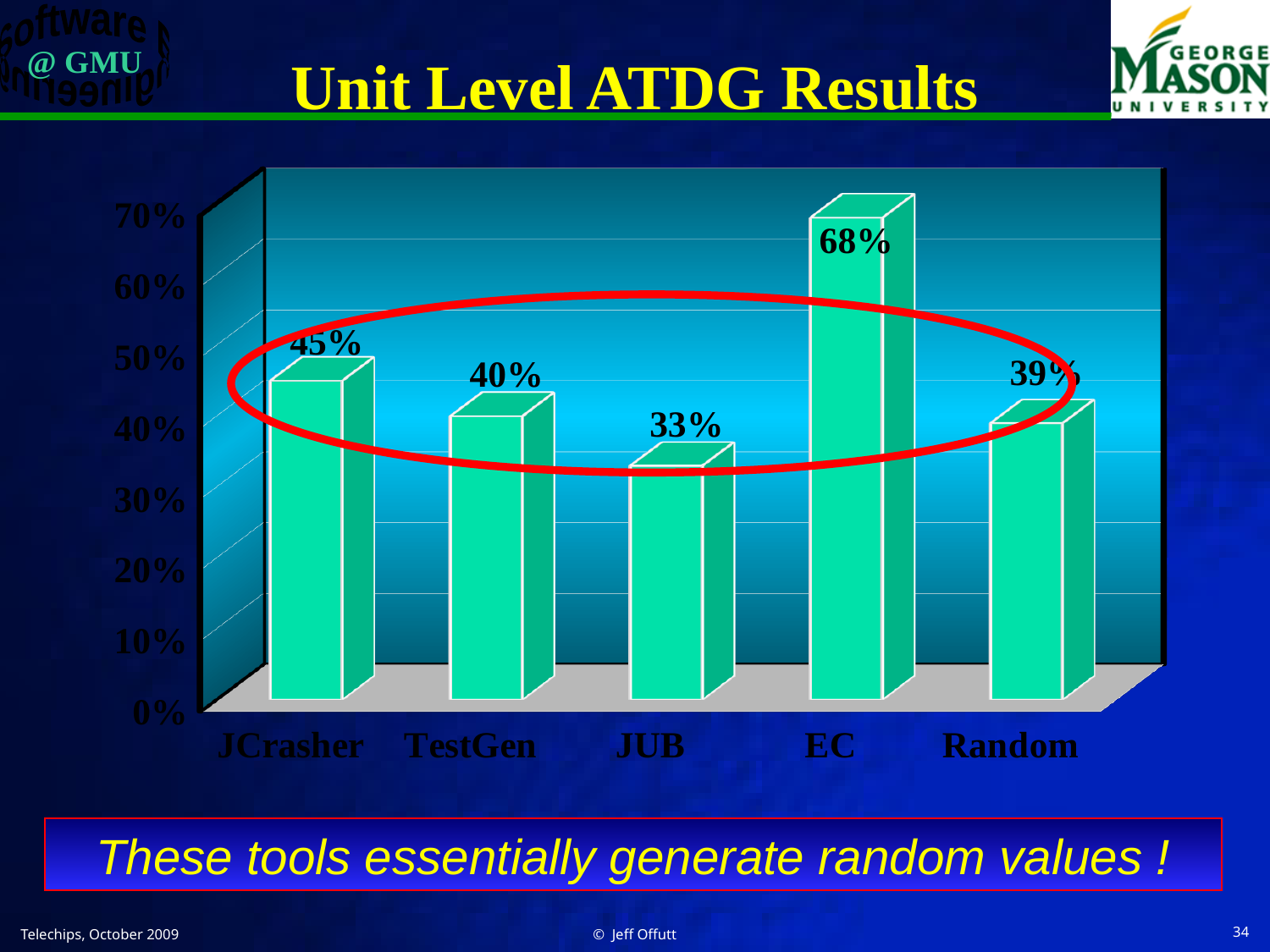
What kind of chart is shown on the slide? bar chart What is the difference between the values for TestGen and JUB? 7% Which category has the highest value? EC What is the title of the slide containing the chart? Unit Level ATDG Results What is the value for Random? 39% What is the value for EC? 68% What is the value for JUB? 33% What is the difference between the values for EC and JCrasher? 23% Which is larger, the value for JCrasher or the value for TestGen? JCrasher How many categories are shown on the x axis? 5 Which category has the lowest value? JUB What is the value for JCrasher? 45%